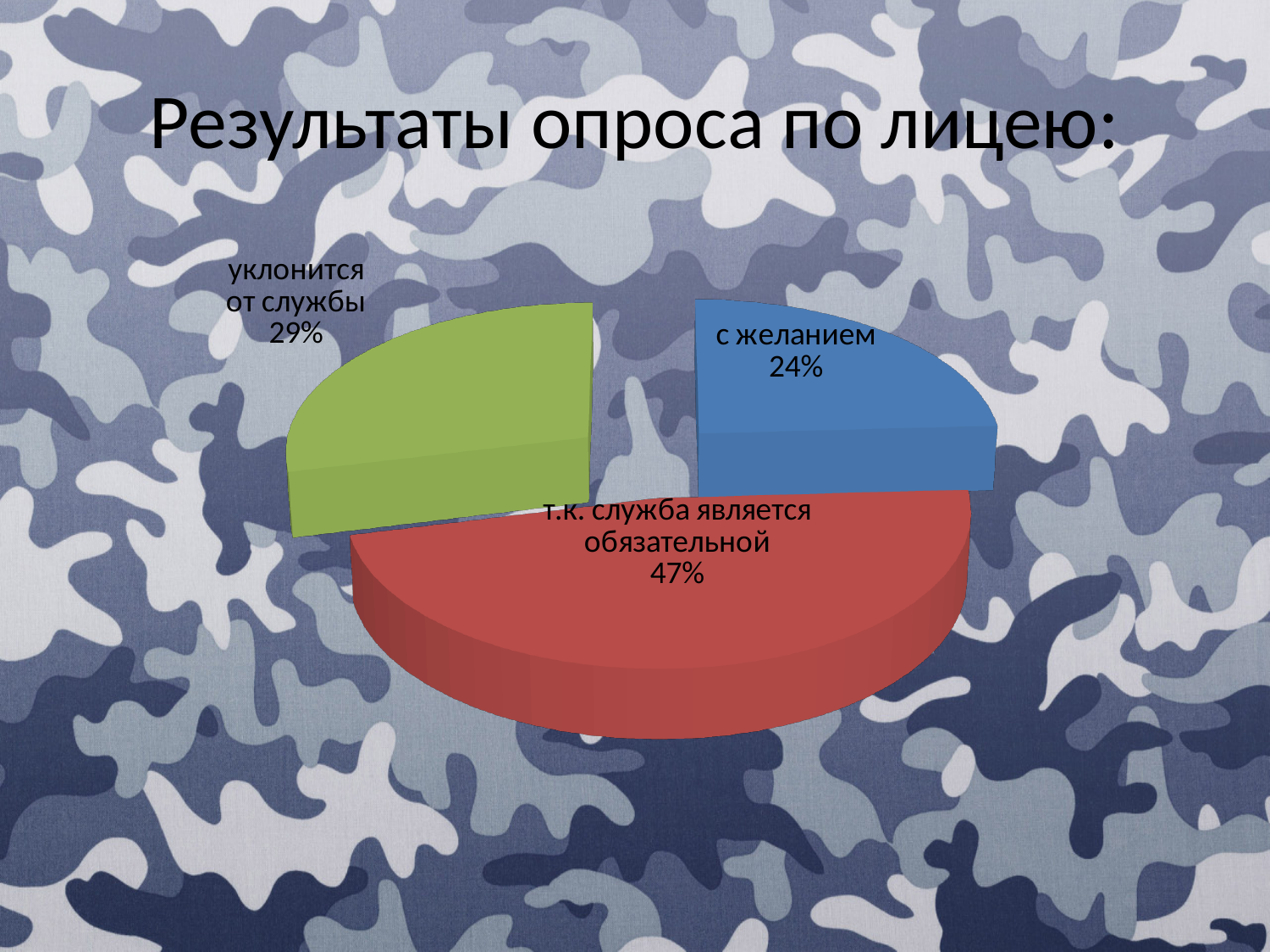
What share of the pie is labelled "уклонится от службы"? 29% Which is larger: the share for "уклонится от службы" or the share for "с желанием"? уклонится от службы Which category has the smallest slice of the pie? с желанием What kind of chart is shown on the slide? pie chart What is the title of the slide? Результаты опроса по лицею: How many slices does the pie chart have? 3 What share of the pie is labelled "т.к. служба является обязательной"? 47% Which category has the largest slice of the pie? т.к. служба является обязательной What is the difference in percentage points between "уклонится от службы" and "с желанием"? 5% What colour is the slice for "т.к. служба является обязательной"? red What is the difference in percentage points between "т.к. служба является обязательной" and "уклонится от службы"? 18% What share of the pie is labelled "с желанием"? 24%